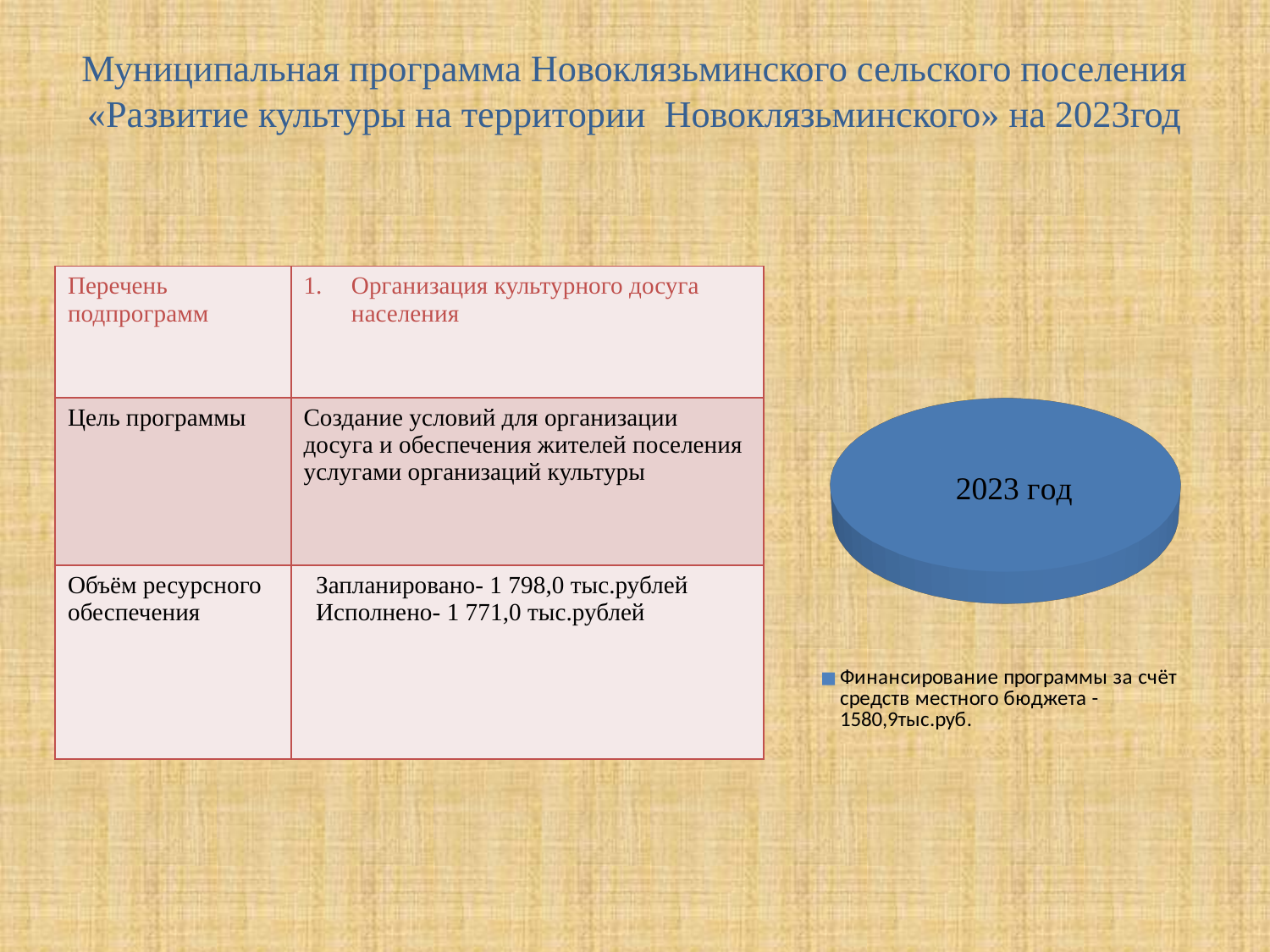
What label is printed on the pie chart slice? 2023 год What colour is the slice of the pie chart? blue How many entries does the legend of the pie chart list? 1 What kind of chart is shown on the slide? pie chart According to the legend, what amount of programme financing from the local budget is shown in the pie chart? 1580,9тыс.руб. How many slices does the pie chart have? 1 What share of the pie does the single slice take up? 100%